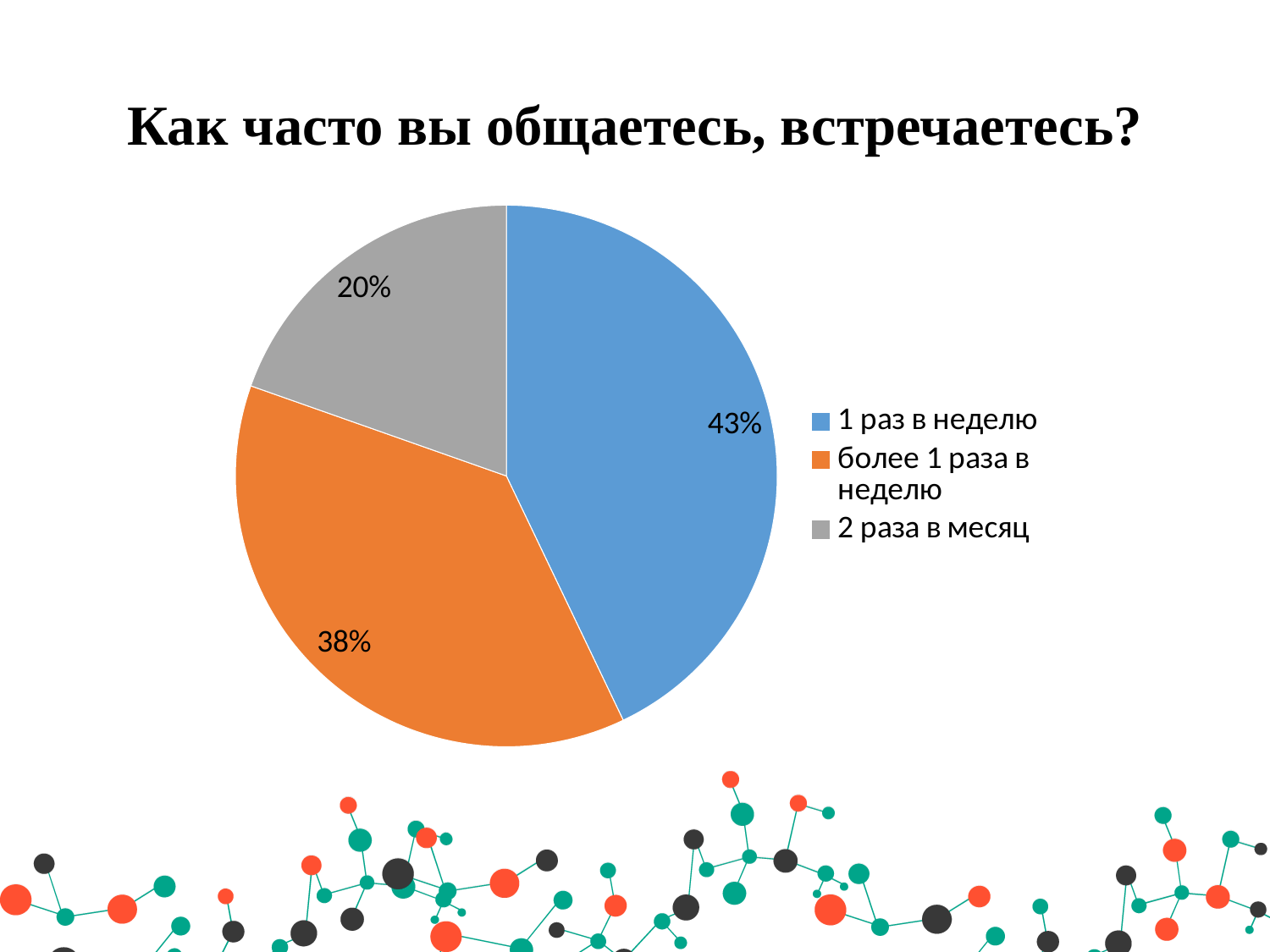
How many categories does the pie chart show? 3 Which category has the smallest slice of the pie? 2 раза в месяц Which category has the largest slice of the pie? 1 раз в неделю What is the difference in percentage points between "1 раз в неделю" and "2 раза в месяц"? 23 What share of the pie does "2 раза в месяц" take? 20% What colour is the slice for "2 раза в месяц"? Grey What share of the pie does "1 раз в неделю" take? 43% What is the title of the chart? Как часто вы общаетесь, встречаетесь? What kind of chart is shown on the slide? Pie chart Which is larger: the slice for "1 раз в неделю" or the slice for "более 1 раза в неделю"? 1 раз в неделю What share of the pie does "более 1 раза в неделю" take? 38% What is the difference in percentage points between "более 1 раза в неделю" and "2 раза в месяц"? 18